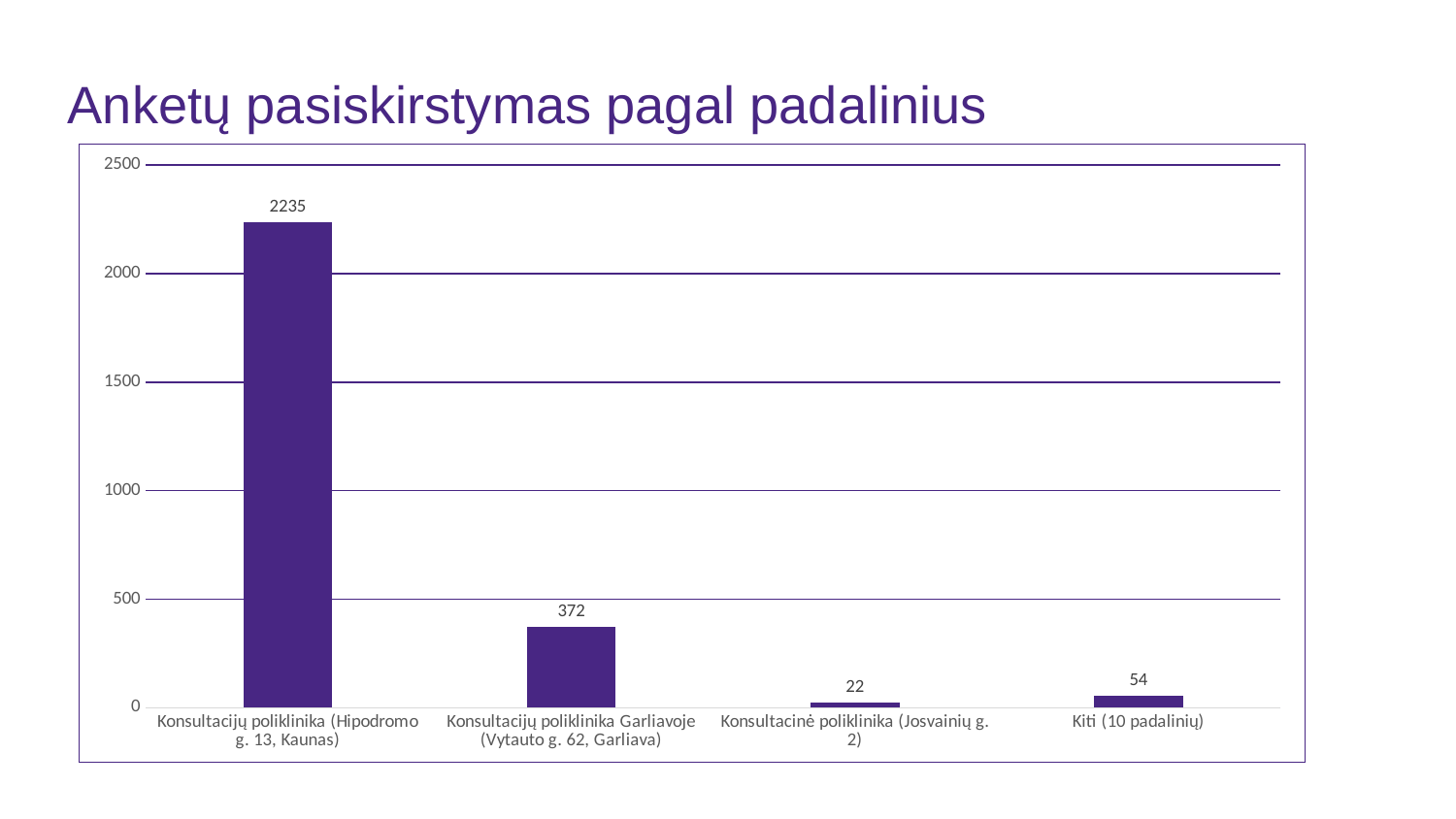
Which category has the lowest value? Konsultacinė poliklinika (Josvainių g. 2) How many categories are shown on the chart? 4 What is the value for Konsultacijų poliklinika Garliavoje (Vytauto g. 62, Garliava)? 372 What is the difference between the values for Konsultacijų poliklinika (Hipodromo g. 13, Kaunas) and Konsultacijų poliklinika Garliavoje (Vytauto g. 62, Garliava)? 1863 What is the value for Konsultacijų poliklinika (Hipodromo g. 13, Kaunas)? 2235 What is the value for Konsultacinė poliklinika (Josvainių g. 2)? 22 What is the value for Kiti (10 padalinių)? 54 Which category has the highest value? Konsultacijų poliklinika (Hipodromo g. 13, Kaunas) What is the difference between the values for Kiti (10 padalinių) and Konsultacinė poliklinika (Josvainių g. 2)? 32 What kind of chart is shown on the slide? bar chart Which is larger, the value for Kiti (10 padalinių) or the value for Konsultacinė poliklinika (Josvainių g. 2)? Kiti (10 padalinių) Is the value for Konsultacijų poliklinika Garliavoje (Vytauto g. 62, Garliava) greater or less than 500? less